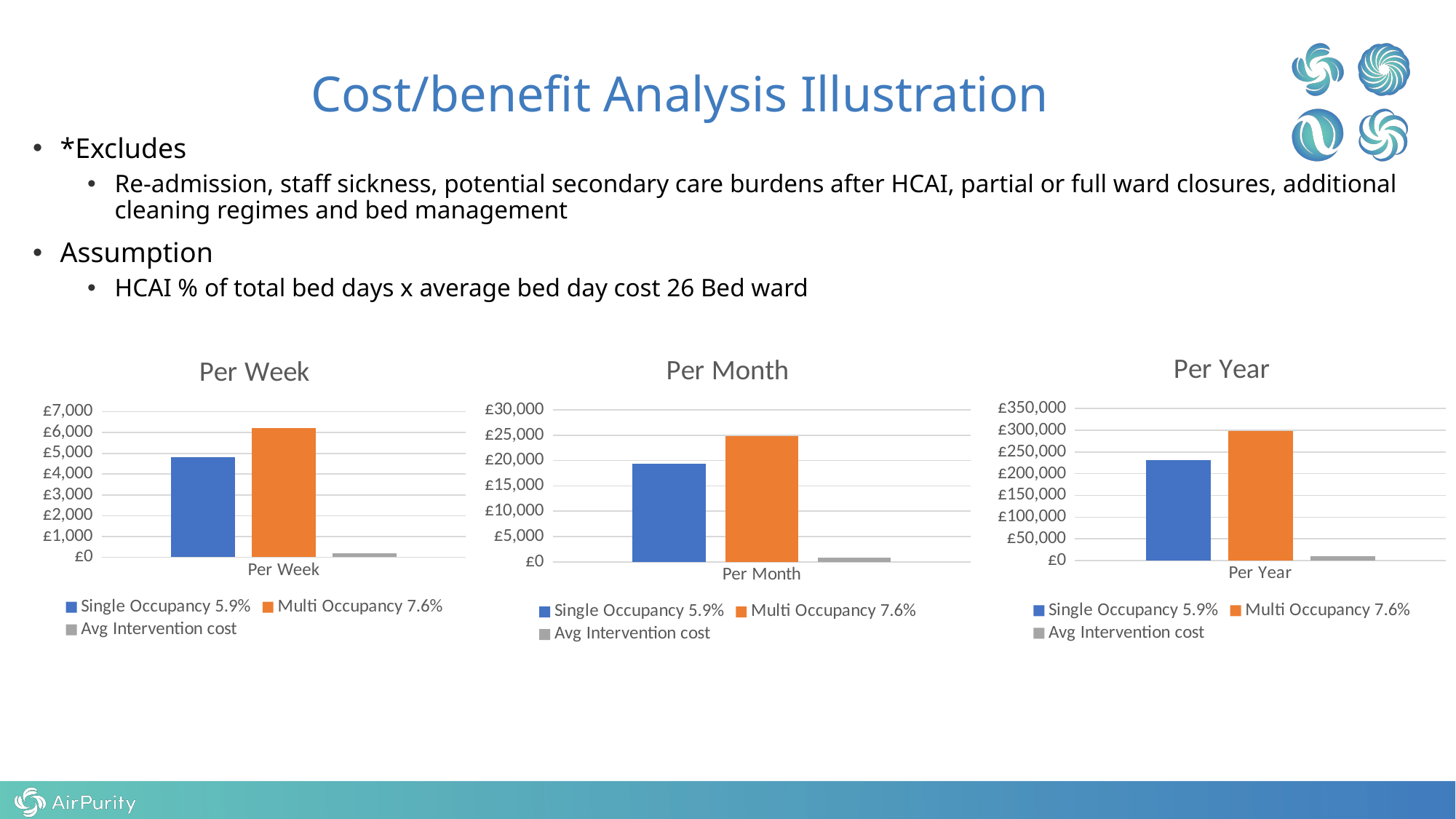
In the Per Week chart, which series has the lowest value? Avg Intervention cost What colour represents Multi Occupancy 7.6% in the Per Week chart? Orange In the Per Month chart, which is larger, Single Occupancy 5.9% or Multi Occupancy 7.6%? Multi Occupancy 7.6% How many series does the legend of the Per Year chart list? 3 In the Per Year chart, is the value for Single Occupancy 5.9% greater or less than £200,000? greater In the Per Month chart, is the value for Avg Intervention cost greater or less than £5,000? less In the Per Week chart, is the value for Multi Occupancy 7.6% greater or less than £7,000? less What kind of chart is the Per Month chart? Bar chart In the Per Week chart, which series has the highest value? Multi Occupancy 7.6% In the Per Year chart, which series has the lowest value? Avg Intervention cost